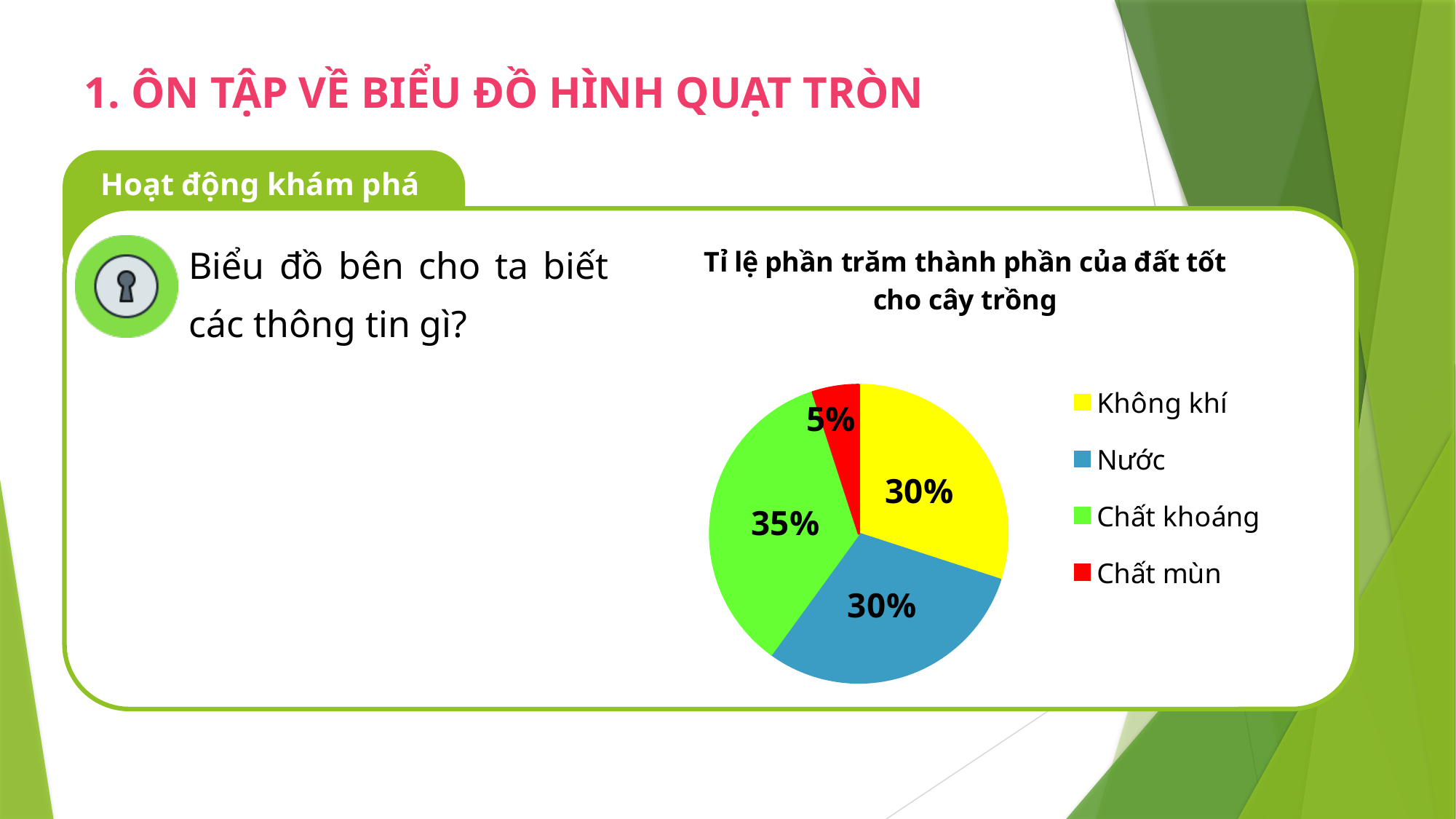
How many categories does the legend list? 4 What kind of chart is shown on the slide? pie chart Which category has the largest share of the pie? Chất khoáng Which category has the smallest share of the pie? Chất mùn What percentage does the Không khí slice represent? 30% Which is larger, the share for Chất khoáng or the share for Nước? Chất khoáng What colour is the Chất mùn slice? red What percentage does the Chất mùn slice represent? 5% What percentage does the Nước slice represent? 30% What is the title of the pie chart? Tỉ lệ phần trăm thành phần của đất tốt cho cây trồng What percentage does the Chất khoáng slice represent? 35% What is the difference in percentage points between Chất khoáng and Chất mùn? 30